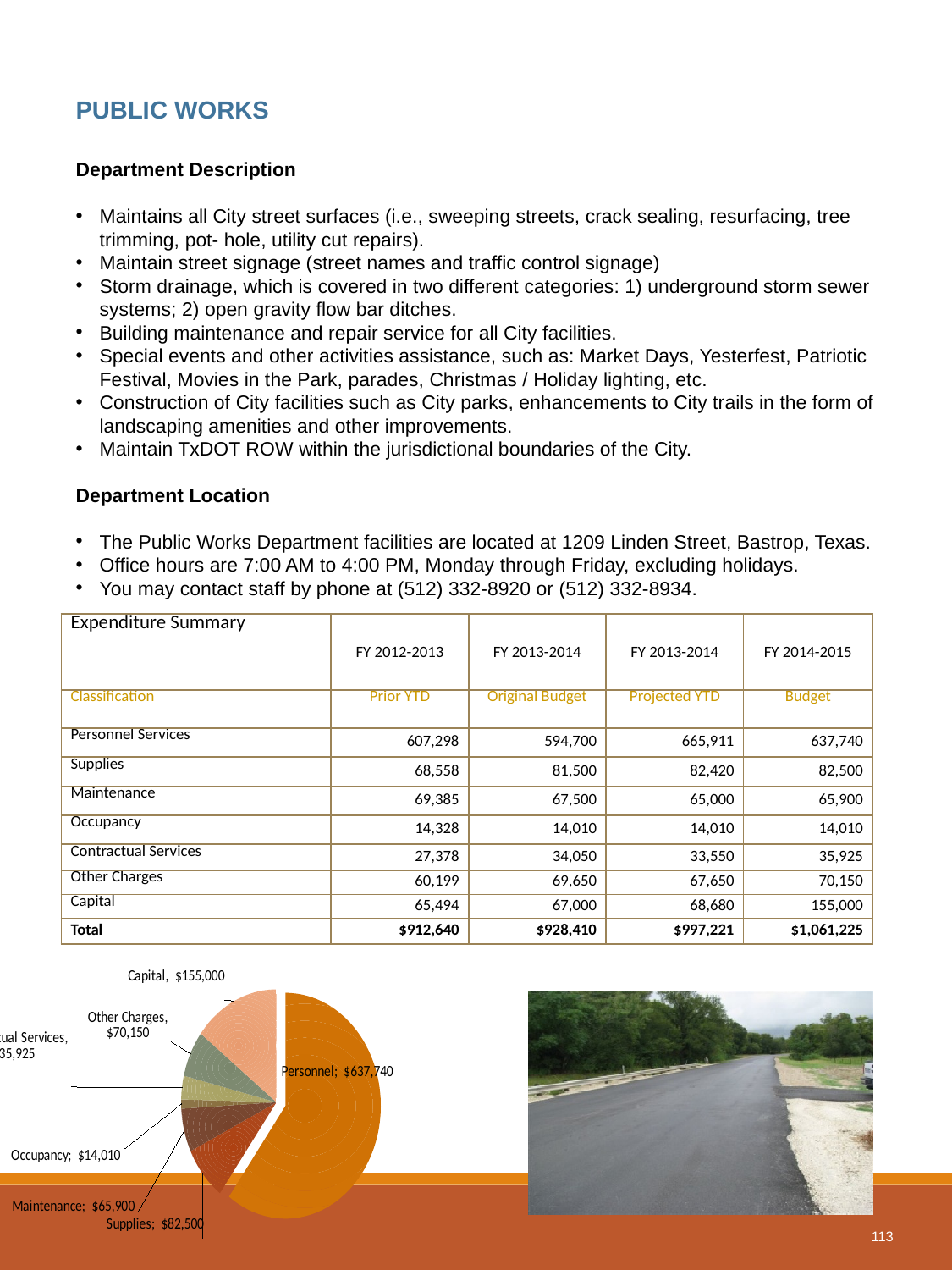
In the pie chart, what is the value shown for Personnel? $637,740 Which category has the smallest slice in the pie chart? Occupancy What kind of chart is shown at the bottom left of the slide? pie chart In the pie chart, what is the difference between the Other Charges value and the Maintenance value? $4,250 In the pie chart, what is the value shown for Capital? $155,000 In the pie chart, what is the value shown for Supplies? $82,500 In the pie chart, what is the difference between the Capital value and the Supplies value? $72,500 How many slices does the pie chart have? 7 In the pie chart, what is the value shown for Other Charges? $70,150 In the pie chart, which is larger: Maintenance or Other Charges? Other Charges In the pie chart, what is the value shown for Occupancy? $14,010 Which category has the largest slice in the pie chart? Personnel